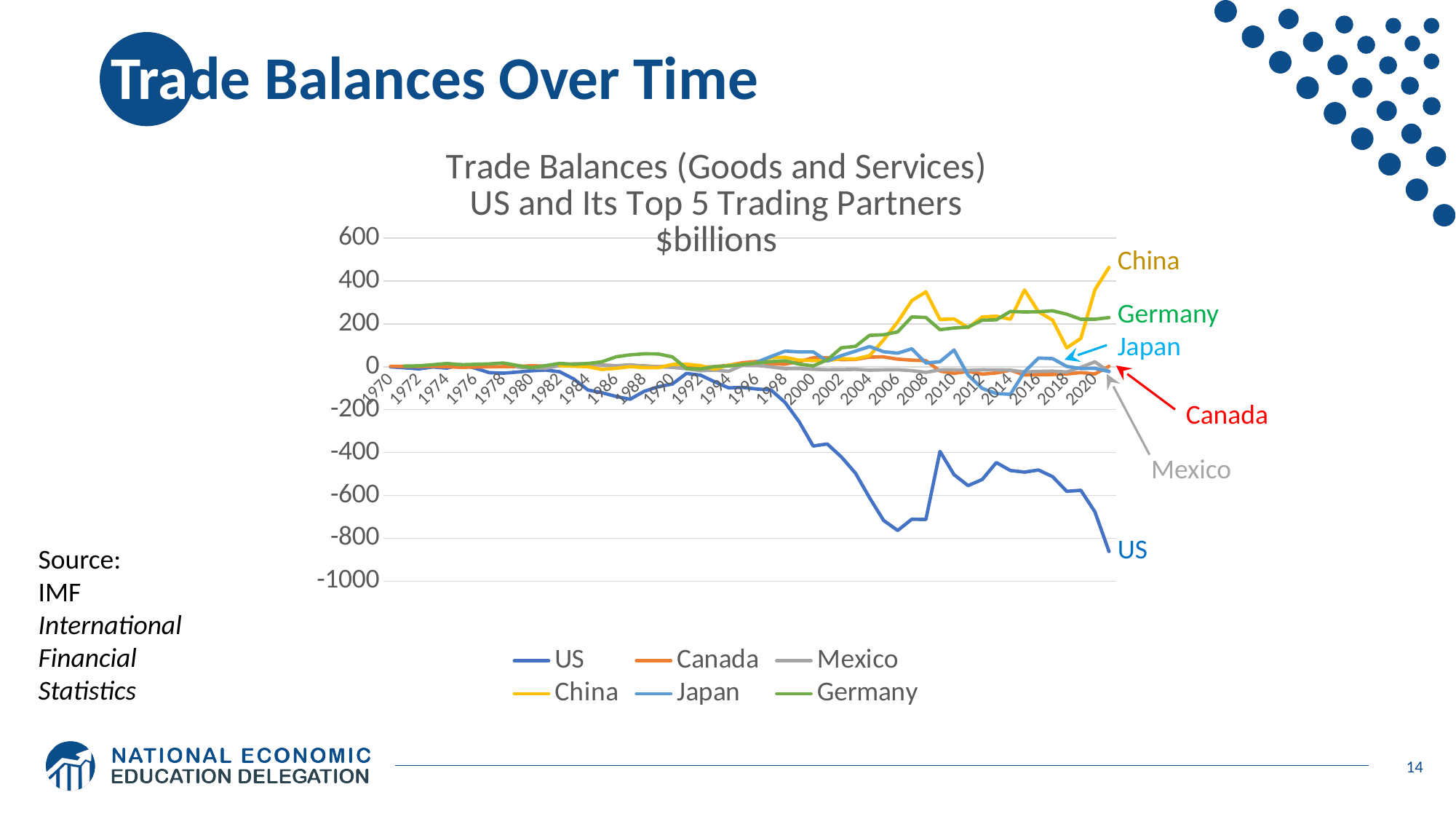
Which country's line has the lowest value in 2020? US What kind of chart is shown on the slide? line chart In 2020, which is larger, the value for China or the value for Germany? China Is the value for the US in 2006 greater or less than -600? less Is the value for China in 2008 greater or less than 200? greater Does the US line rise or fall between 1998 and 2006? fall What is the first year shown on the x axis? 1970 Is the value for China in 2020 greater or less than 400? less How many series does the legend list? 6 What unit is stated in the chart title? $billions Which country's line has the highest value in 2020? China